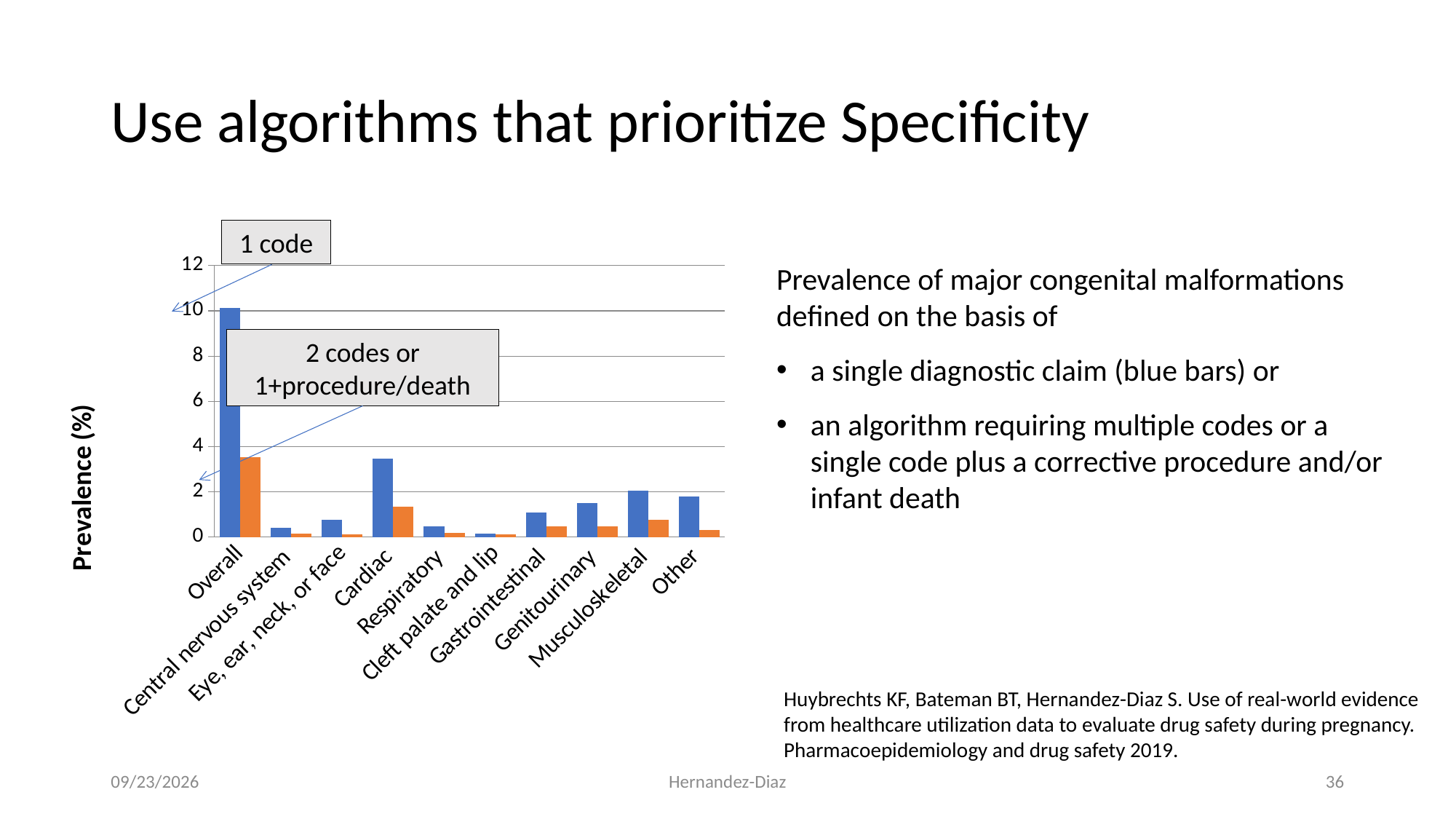
Which category has the lowest blue bar in the chart? Cleft palate and lip Is the orange bar for Overall greater or less than 4? less Which category has the highest blue bar in the chart? Overall Which has the larger orange bar, Overall or Cardiac? Overall What kind of chart is shown on the slide? bar chart Is the blue bar for Genitourinary greater or less than 2? less What is the label on the y axis of the chart? Prevalence (%) How many categories are shown on the x axis of the chart? 10 Is the blue bar for Overall greater or less than 8? greater Which has the larger blue bar, Cardiac or Musculoskeletal? Cardiac According to the callout on the chart, what do the blue bars represent? 1 code